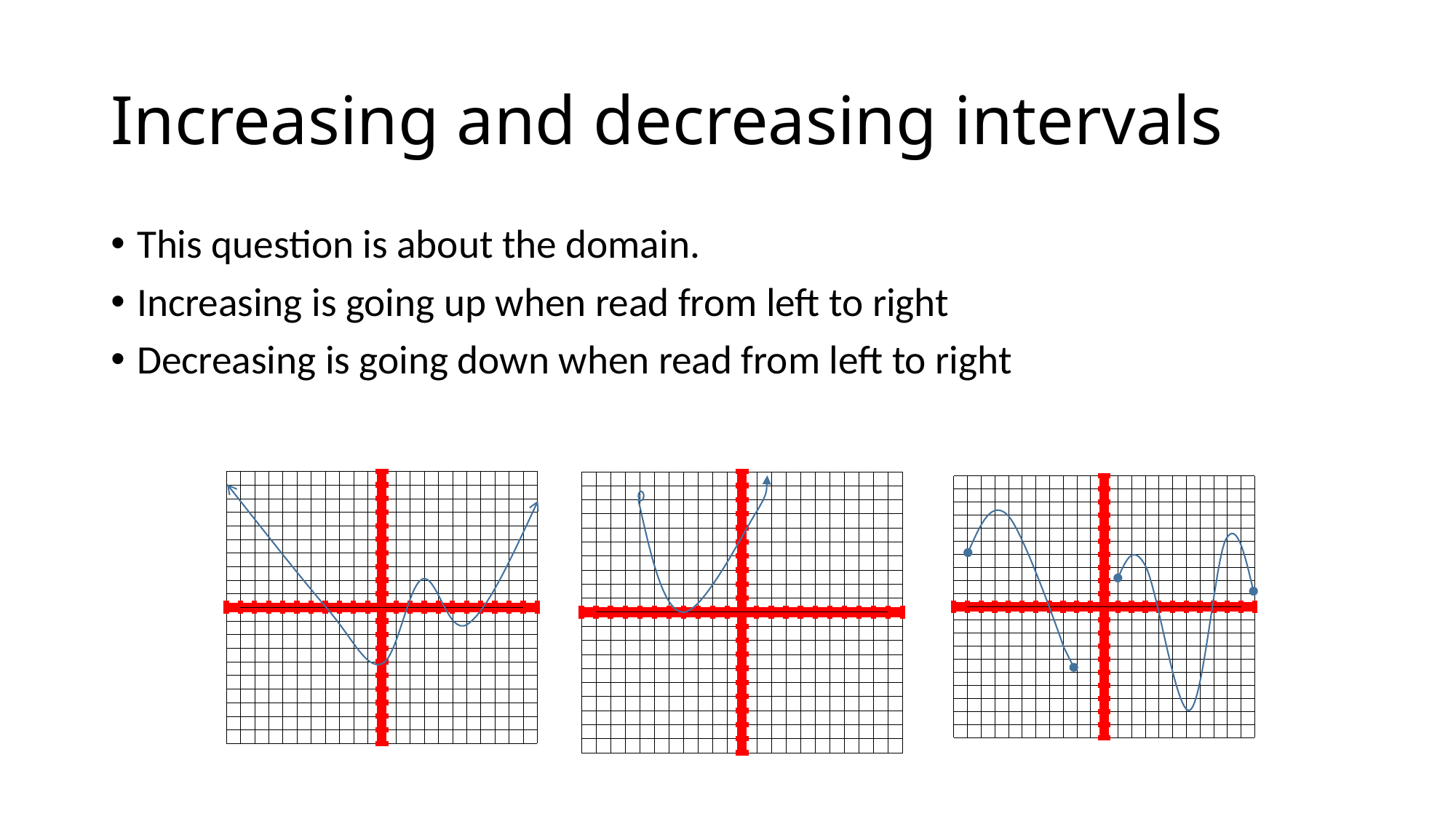
What colour are the x and y axes drawn in on the three graphs? red In the middle graph, does the curve rise or fall from its left endpoint down to its lowest point? fall In the middle graph, is the left endpoint of the curve drawn as an open circle or a filled dot? open circle In the left graph, does the curve rise or fall when read from the left edge toward the y-axis? fall In the right graph, does the curve rise or fall immediately after its leftmost endpoint? rise How many graphs are shown on the slide? 3